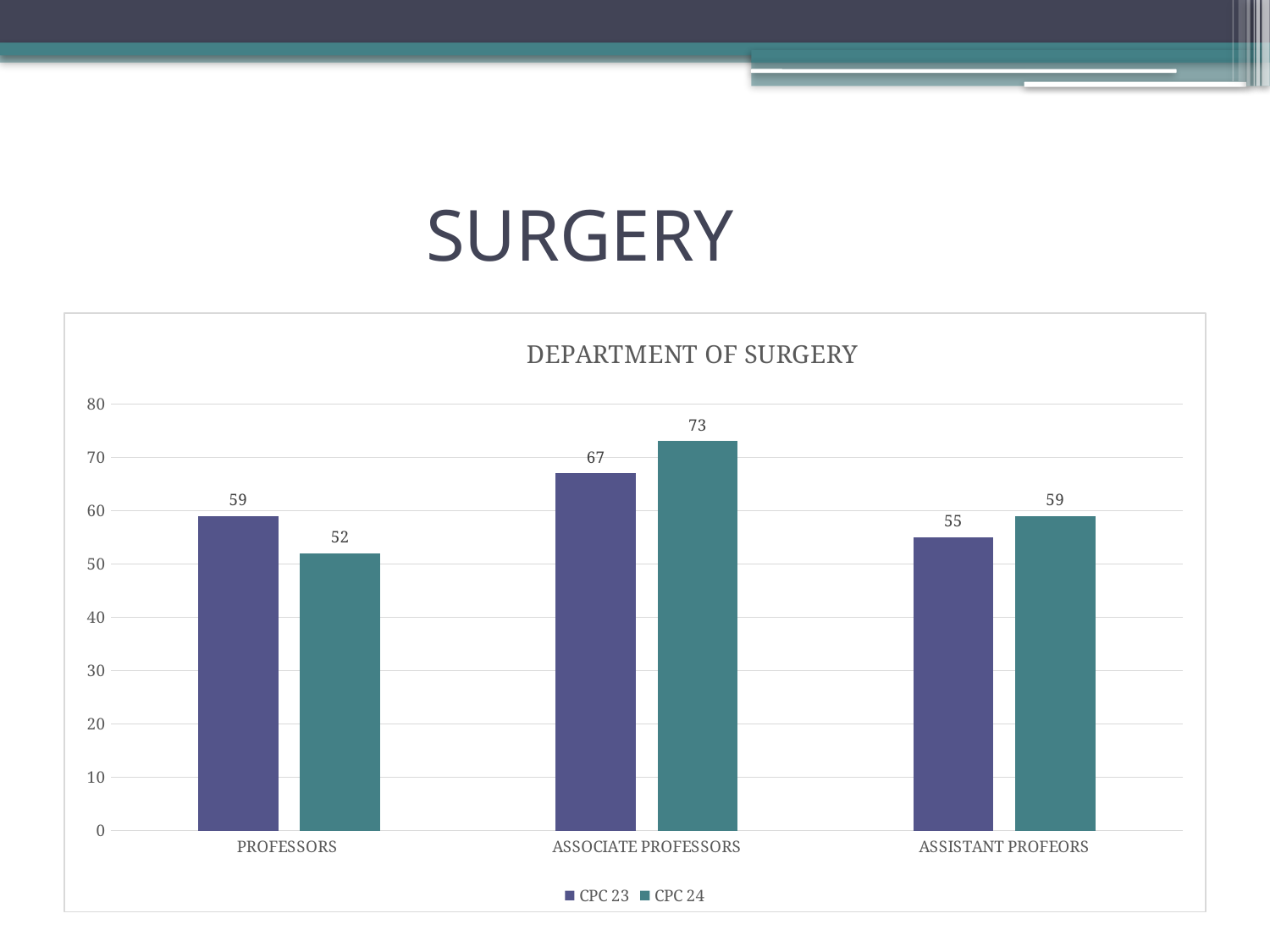
What is the CPC 23 value for PROFESSORS? 59 Which category has the highest CPC 24 value? ASSOCIATE PROFESSORS How many categories are shown on the x axis? 3 What is the CPC 23 value for ASSISTANT PROFEORS? 55 What is the difference between the CPC 24 and CPC 23 values for ASSOCIATE PROFESSORS? 6 What type of chart is shown? bar chart How many series does the legend list? 2 What is the CPC 24 value for ASSOCIATE PROFESSORS? 73 For PROFESSORS, which is larger: CPC 23 or CPC 24? CPC 23 Is the CPC 24 value for ASSOCIATE PROFESSORS greater or less than 70? greater Which category has the lowest CPC 23 value? ASSISTANT PROFEORS What is the difference between the CPC 23 and CPC 24 values for PROFESSORS? 7